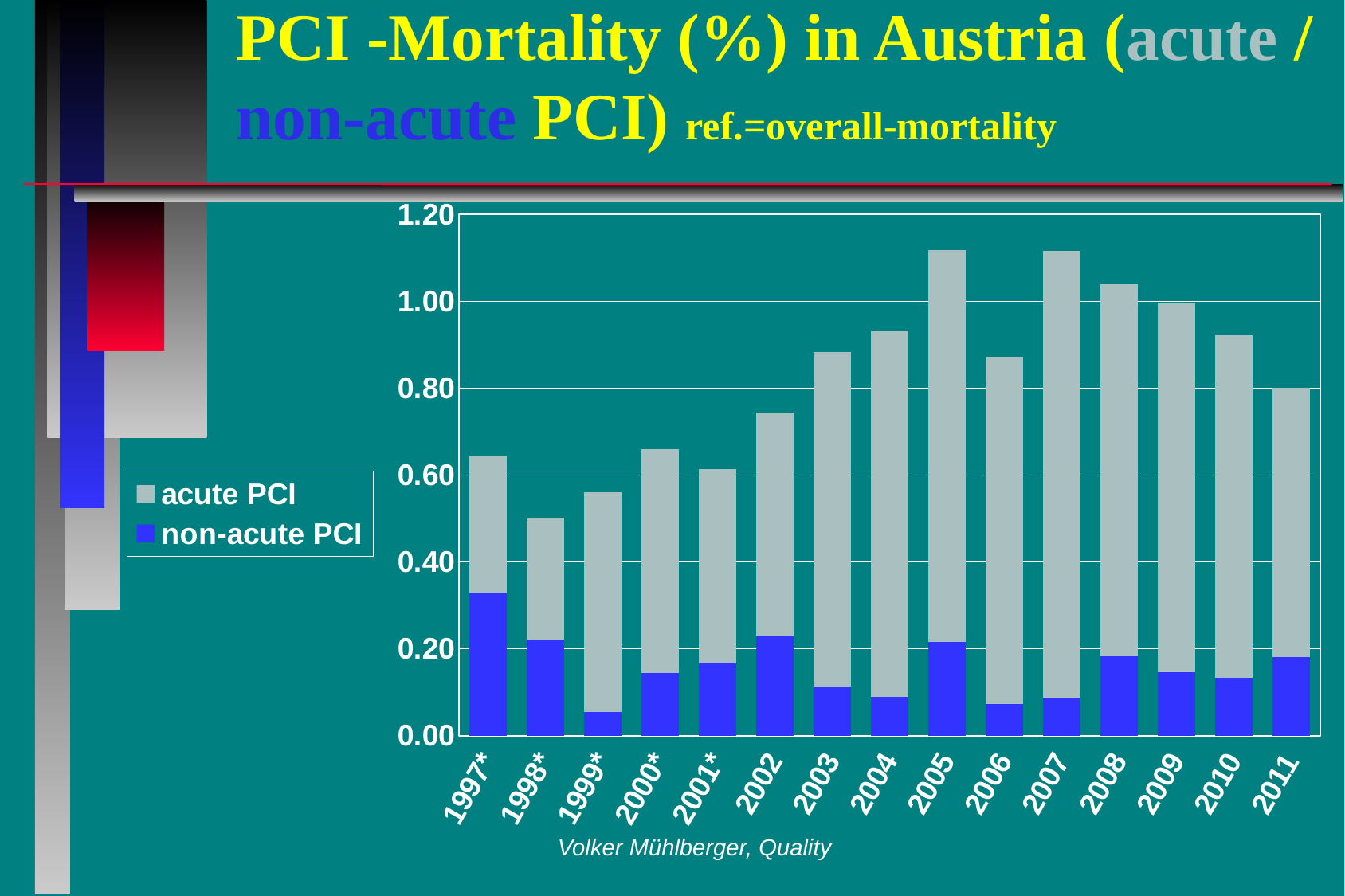
Which year has the taller total bar, 2002 or 2003? 2003 Which year has the lowest non-acute PCI mortality? 1999* How many series does the chart's legend list? 2 Is the non-acute PCI value for 1997* greater or less than 0.20? greater How many years are shown along the x axis of the chart? 15 Which year has the highest non-acute PCI mortality? 1997* Is the total bar for 2011 greater or less than 1.00? less Do the total bars rise or fall from 2007 to 2011? fall What kind of chart is shown on the slide? bar chart Which year has the lowest total bar (acute plus non-acute PCI mortality)? 1998* Which colour represents non-acute PCI in the legend? blue Is the total bar for 2005 greater or less than 1.00? greater